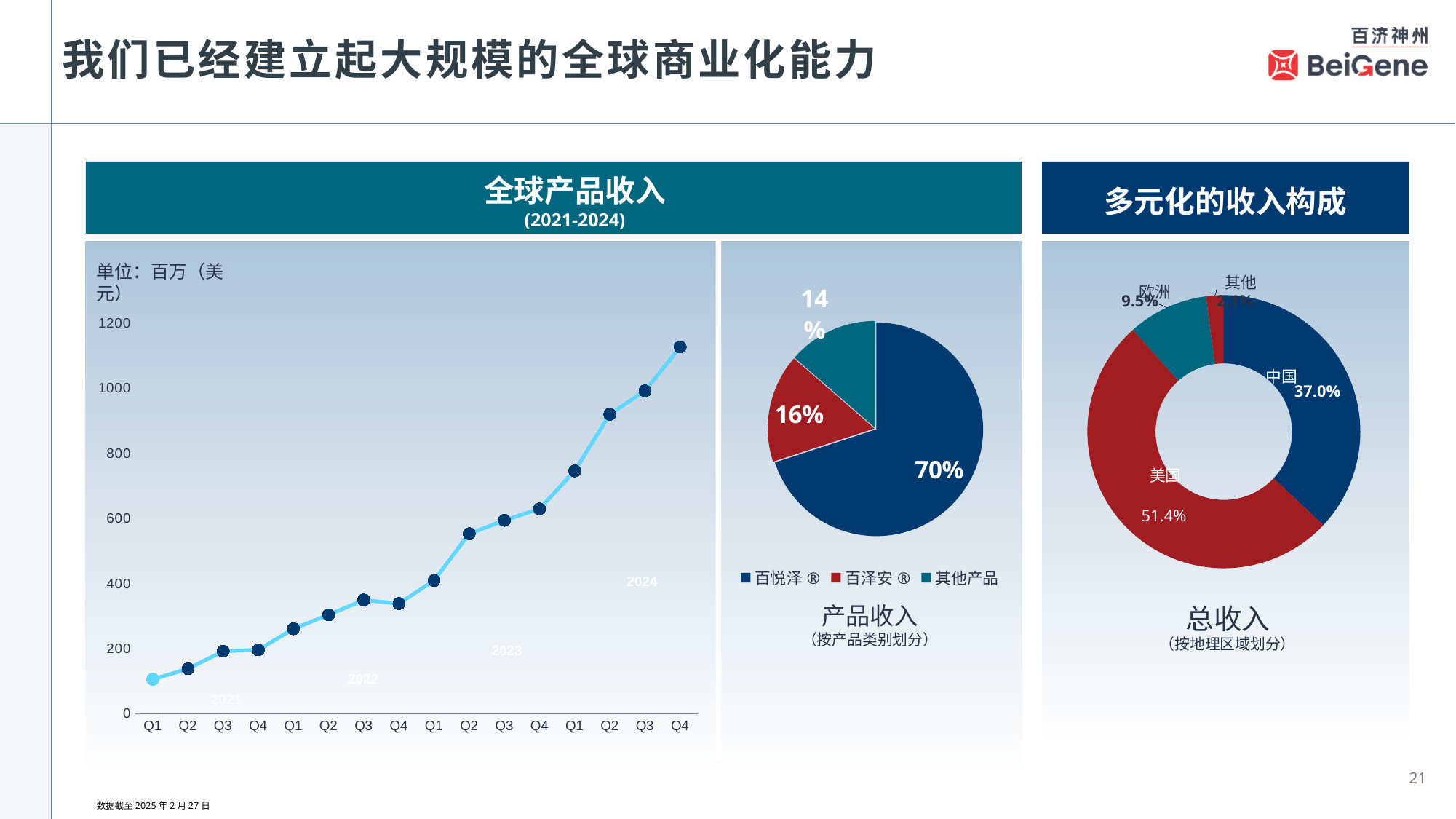
In the 总收入 (按地理区域划分) donut chart, what share does 美国 have? 51.4% In the 产品收入 (按产品类别划分) pie chart, which category has the smallest share? 其他产品 In the 产品收入 (按产品类别划分) pie chart, what share does 百悦泽 ® have? 70% In the 全球产品收入 (2021-2024) line chart, is the value for Q1 2021 greater or less than 200? less In the 全球产品收入 (2021-2024) line chart, do the values generally rise or fall from Q1 2021 to Q4 2024? rise In the 全球产品收入 (2021-2024) line chart, how many quarterly data points are plotted? 16 In the 全球产品收入 (2021-2024) line chart, is the value for Q2 2023 greater or less than 400? greater What kind of chart is the 全球产品收入 (2021-2024) chart on the left? line chart In the 总收入 (按地理区域划分) donut chart, what is the difference between the shares of 美国 and 中国? 14.4% In the 产品收入 (按产品类别划分) pie chart, what share does 百泽安 ® have? 16% In the 全球产品收入 (2021-2024) line chart, is the value for Q4 2024 greater or less than 1000? greater In the 产品收入 (按产品类别划分) pie chart, how many categories does the legend list? 3